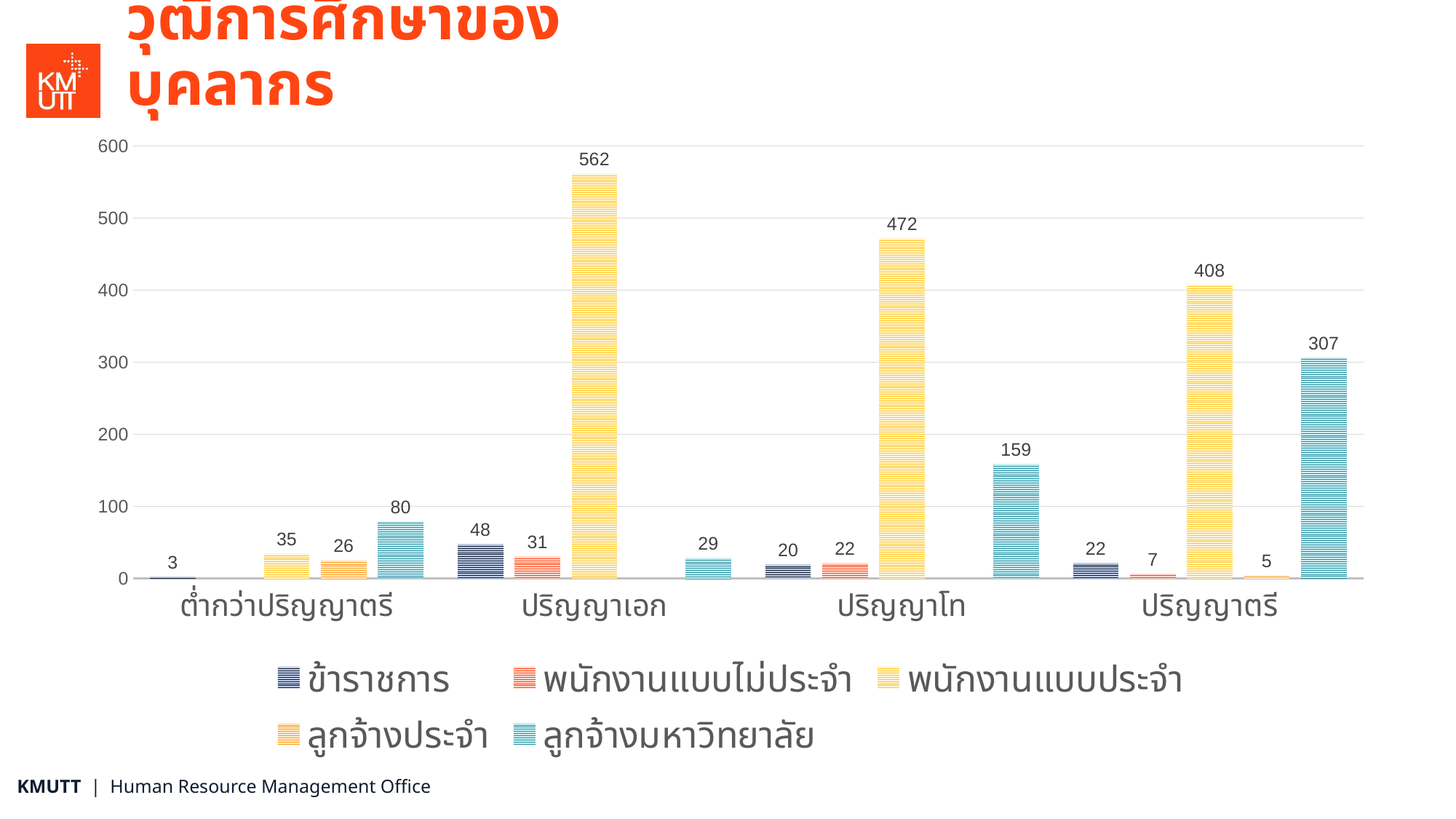
How many categories are shown on the x axis? 4 Which category has the lowest value for ลูกจ้างมหาวิทยาลัย? ปริญญาเอก What is the value for พนักงานแบบประจำ in the ปริญญาเอก category? 562 Which is larger: ลูกจ้างมหาวิทยาลัย for ปริญญาโท or ลูกจ้างมหาวิทยาลัย for ต่ำกว่าปริญญาตรี? ปริญญาโท Which category has the highest value for พนักงานแบบประจำ? ปริญญาเอก Which series is shown in yellow in the legend? พนักงานแบบประจำ What is the value for ลูกจ้างมหาวิทยาลัย in the ปริญญาตรี category? 307 How many series does the legend list? 5 What kind of chart is shown on the slide? bar chart What is the value for ข้าราชการ in the ต่ำกว่าปริญญาตรี category? 3 What is the difference between the พนักงานแบบประจำ values for ปริญญาโท and ปริญญาตรี? 64 Is the value for พนักงานแบบประจำ in the ปริญญาโท category greater or less than 400? greater